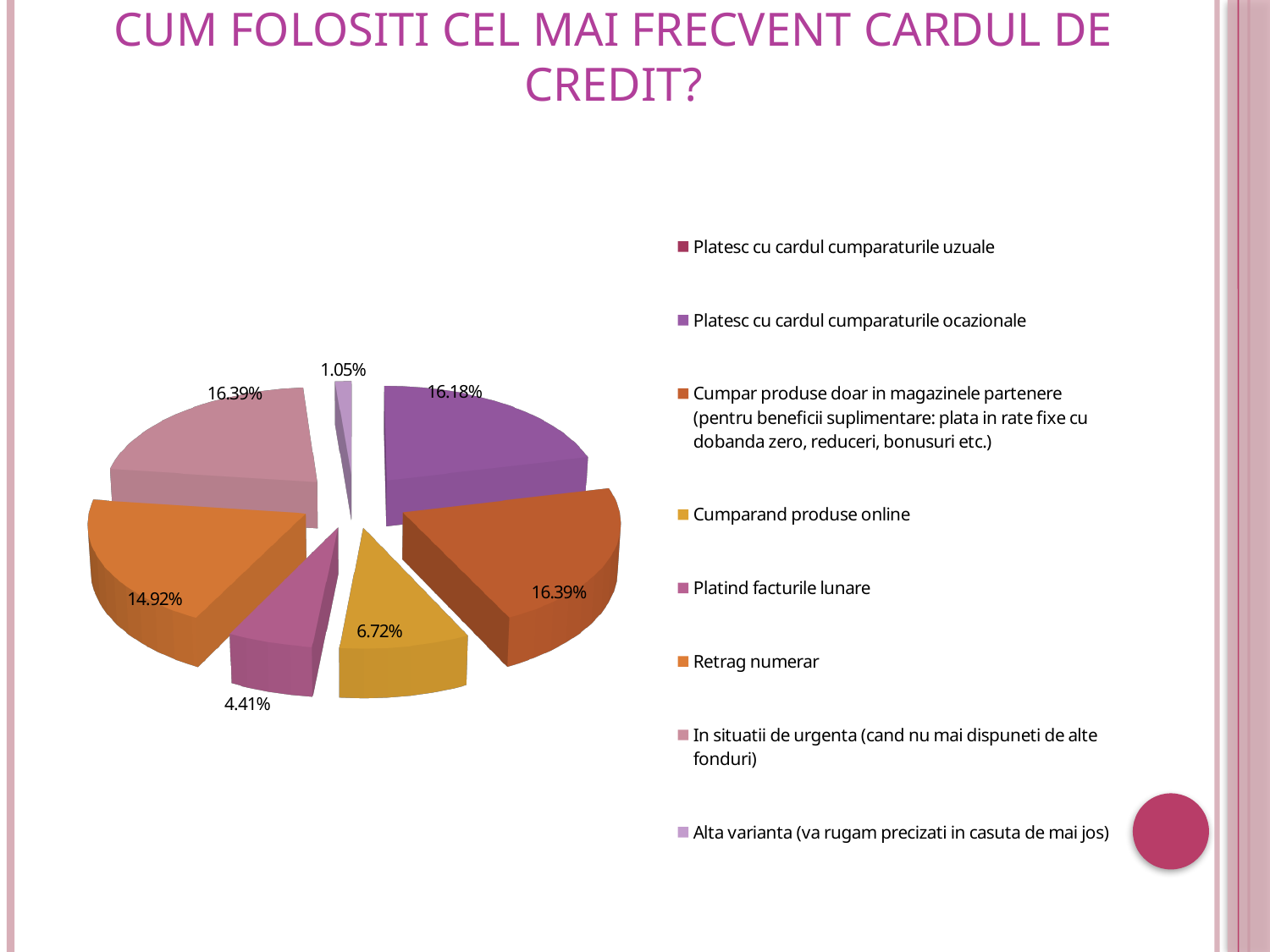
What is the difference in percentage points between 'Retrag numerar' and 'Platind facturile lunare'? 10.51 What percentage is shown for 'Cumparand produse online'? 6.72% How many categories does the legend of the pie chart list? 8 Which is larger: the slice for 'Cumparand produse online' or the slice for 'Platind facturile lunare'? Cumparand produse online What percentage is shown for 'Alta varianta (va rugam precizati in casuta de mai jos)'? 1.05% What is the difference in percentage points between 'Platesc cu cardul cumparaturile ocazionale' and 'Cumparand produse online'? 9.46 What percentage is shown for 'Retrag numerar'? 14.92% Which category has the smallest slice of the pie? Alta varianta (va rugam precizati in casuta de mai jos) What percentage is shown for 'Platesc cu cardul cumparaturile ocazionale'? 16.18% What kind of chart is shown on the slide? Pie chart What percentage is shown for 'Platind facturile lunare'? 4.41% What is the title of the slide containing the pie chart? CUM FOLOSITI CEL MAI FRECVENT CARDUL DE CREDIT?